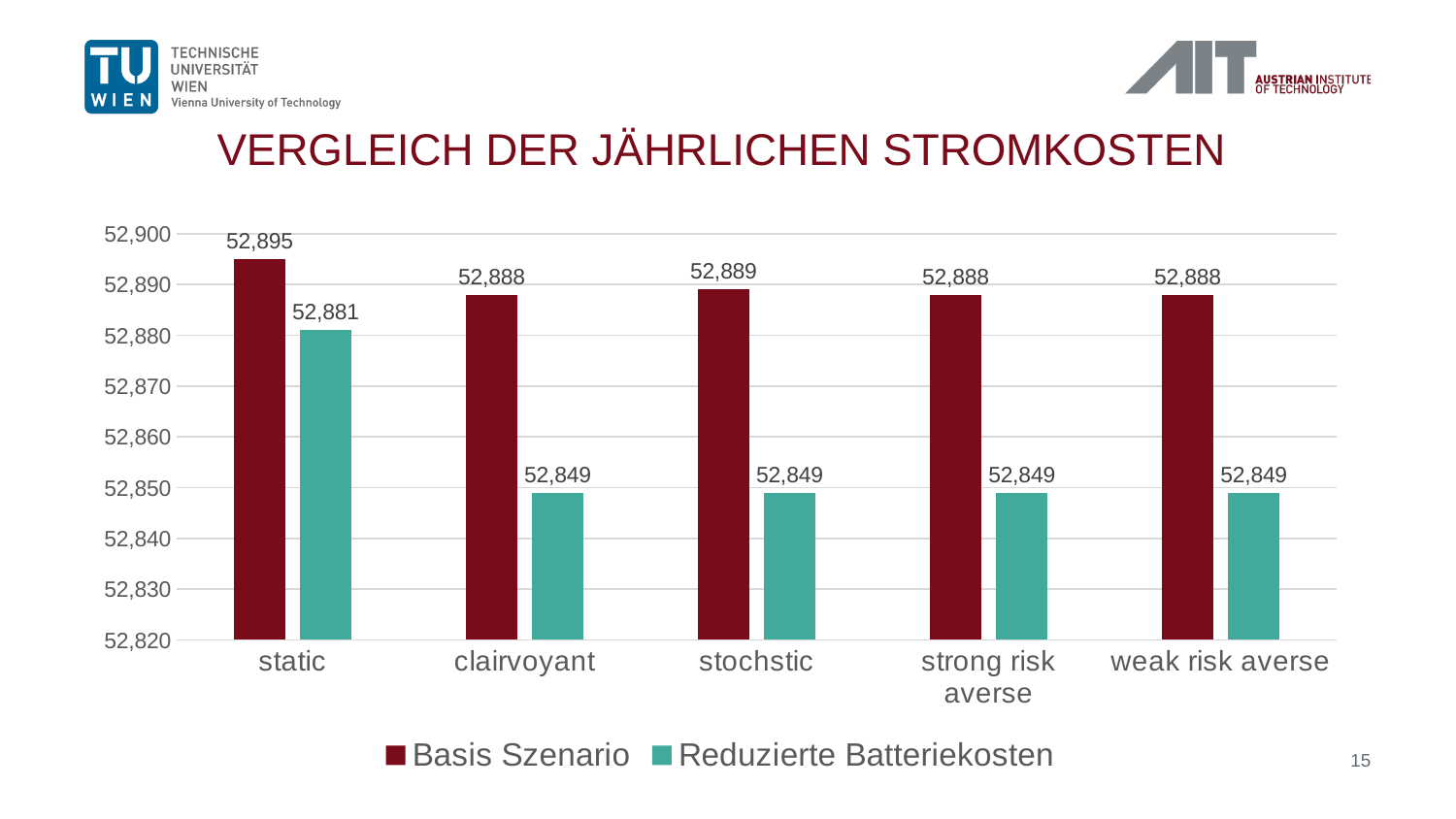
What type of chart is shown on the slide? bar chart What is the value for Basis Szenario in the stochstic category? 52,889 What is the value for Basis Szenario in the static category? 52,895 How many series does the legend list? 2 Which category has the highest Reduzierte Batteriekosten value? static How many categories are shown on the x axis? 5 What is the difference between the Basis Szenario and Reduzierte Batteriekosten values in the weak risk averse category? 39 What is the value for Reduzierte Batteriekosten in the static category? 52,881 Which category has the highest Basis Szenario value? static What is the difference between the Basis Szenario and Reduzierte Batteriekosten values in the static category? 14 Which is larger: the Basis Szenario value for static or the Basis Szenario value for clairvoyant? static What is the value for Reduzierte Batteriekosten in the clairvoyant category? 52,849